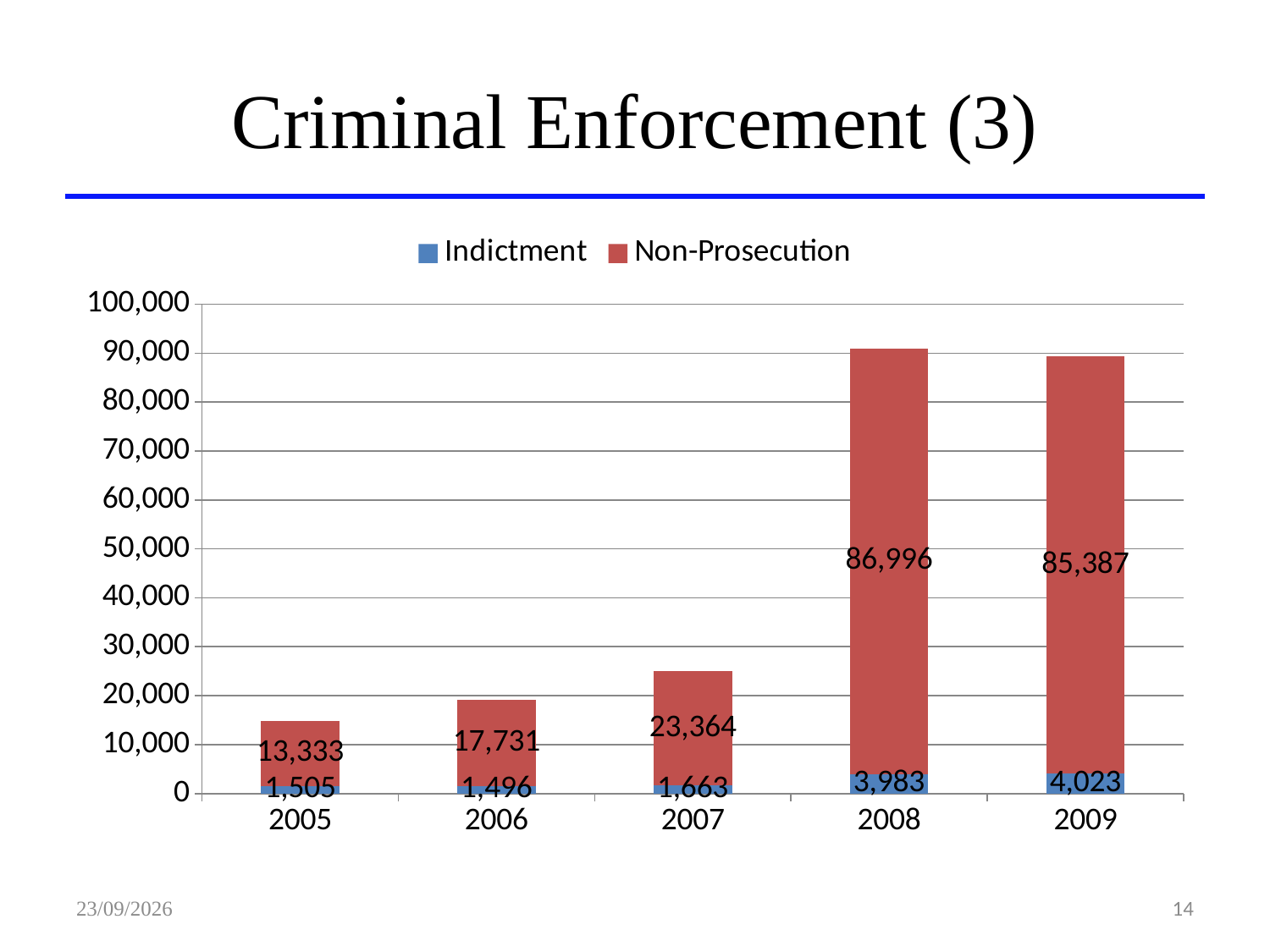
What is the Indictment value for 2006? 1,496 Is the total stacked bar for 2007 greater or less than 20,000? greater Which year has the highest Non-Prosecution value? 2008 What is the Non-Prosecution value for 2008? 86,996 How many years are shown on the x axis? 5 How many series does the legend list? 2 What kind of chart is shown on the slide? stacked bar chart What is the total of the stacked bar for 2005? 14,838 What is the Non-Prosecution value for 2005? 13,333 What is the difference between the Non-Prosecution values for 2008 and 2009? 1,609 Which is larger, the Indictment value for 2009 or for 2008? 2009 Which year has the lowest Indictment value? 2006